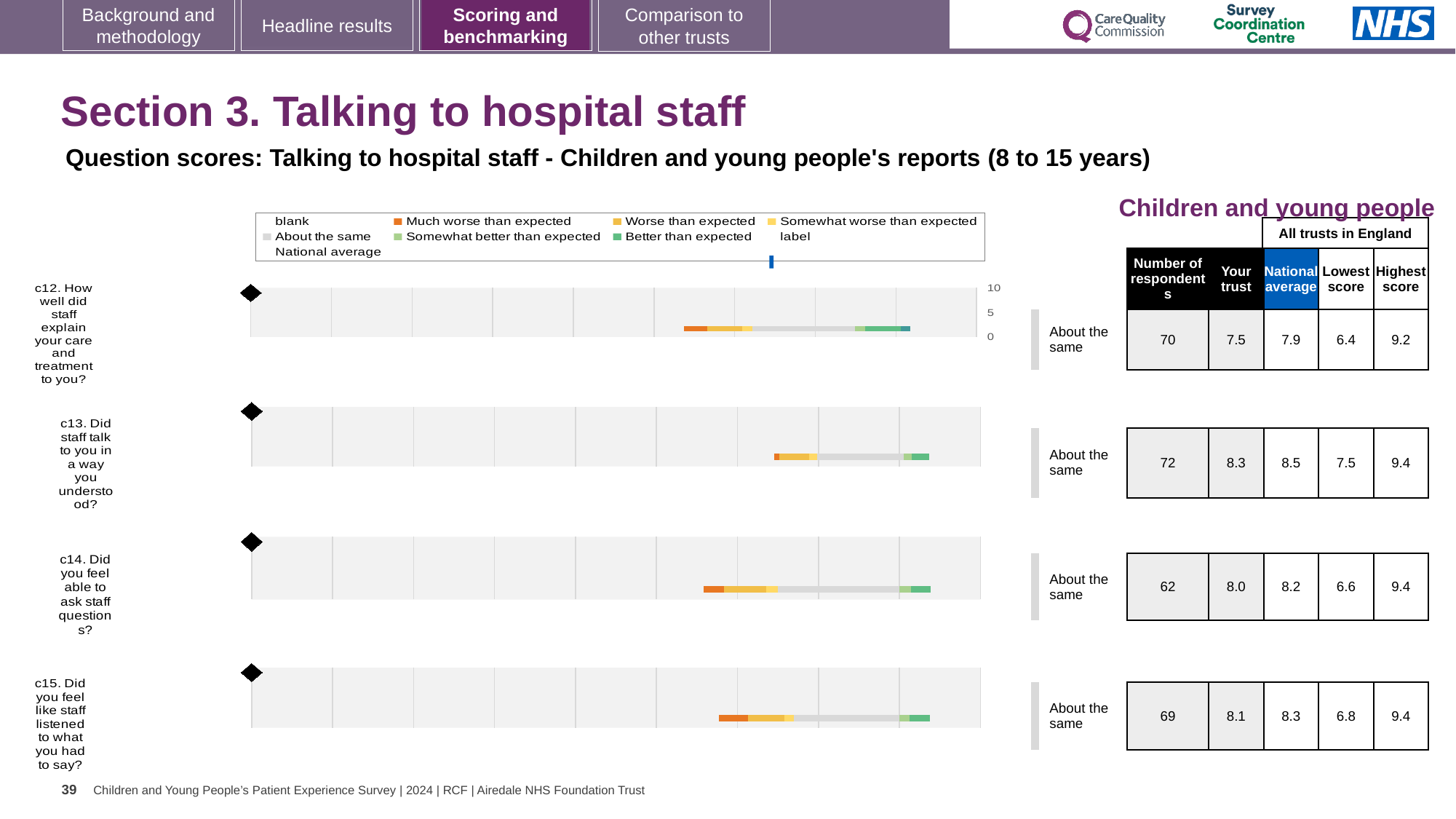
What type of chart is used to show the question scores for c12 to c15? bar chart What is the highest score across all trusts in England for c15 (Did you feel like staff listened to what you had to say?)? 9.4 Which question has the lowest 'Your trust' score? c12. How well did staff explain your care and treatment to you? Which question has the highest 'Your trust' score? c13. Did staff talk to you in a way you understood? How many respondents answered c14 (Did you feel able to ask staff questions?)? 62 Is the 'Your trust' score for c15 greater or less than 5? greater What is the 'Your trust' score for c13 (Did staff talk to you in a way you understood?)? 8.3 How many survey questions are plotted on the slide? 4 What benchmark label is shown next to each of the four question charts? About the same What is the difference between the national average and the 'Your trust' score for c12? 0.4 Which is larger for c14: the 'Your trust' score or the national average? National average What is the national average score for c12 (How well did staff explain your care and treatment to you?)? 7.9